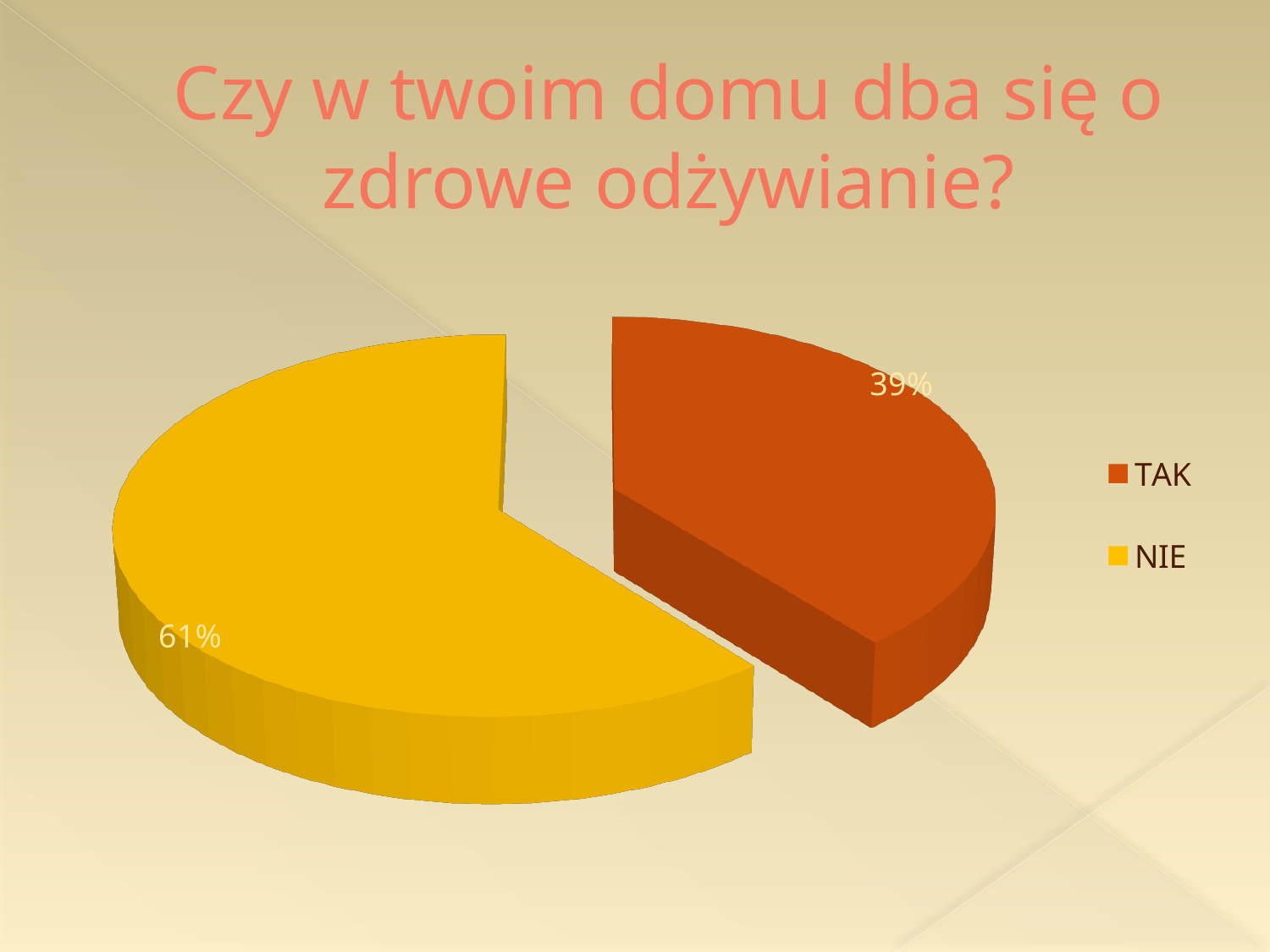
Which is larger, the TAK slice or the NIE slice? NIE What percentage of the pie is labelled NIE? 61% What kind of chart is shown on the slide? pie chart How many slices does the pie chart have? 2 Which slice is the largest? NIE Which slice is the smallest? TAK What is the title of the chart? Czy w twoim domu dba się o zdrowe odżywianie? What percentage of the pie is labelled TAK? 39% Is the share for NIE greater or less than 50%? greater How many entries does the legend list? 2 What colour is the TAK slice? orange-red What is the difference in percentage points between the NIE slice and the TAK slice? 22